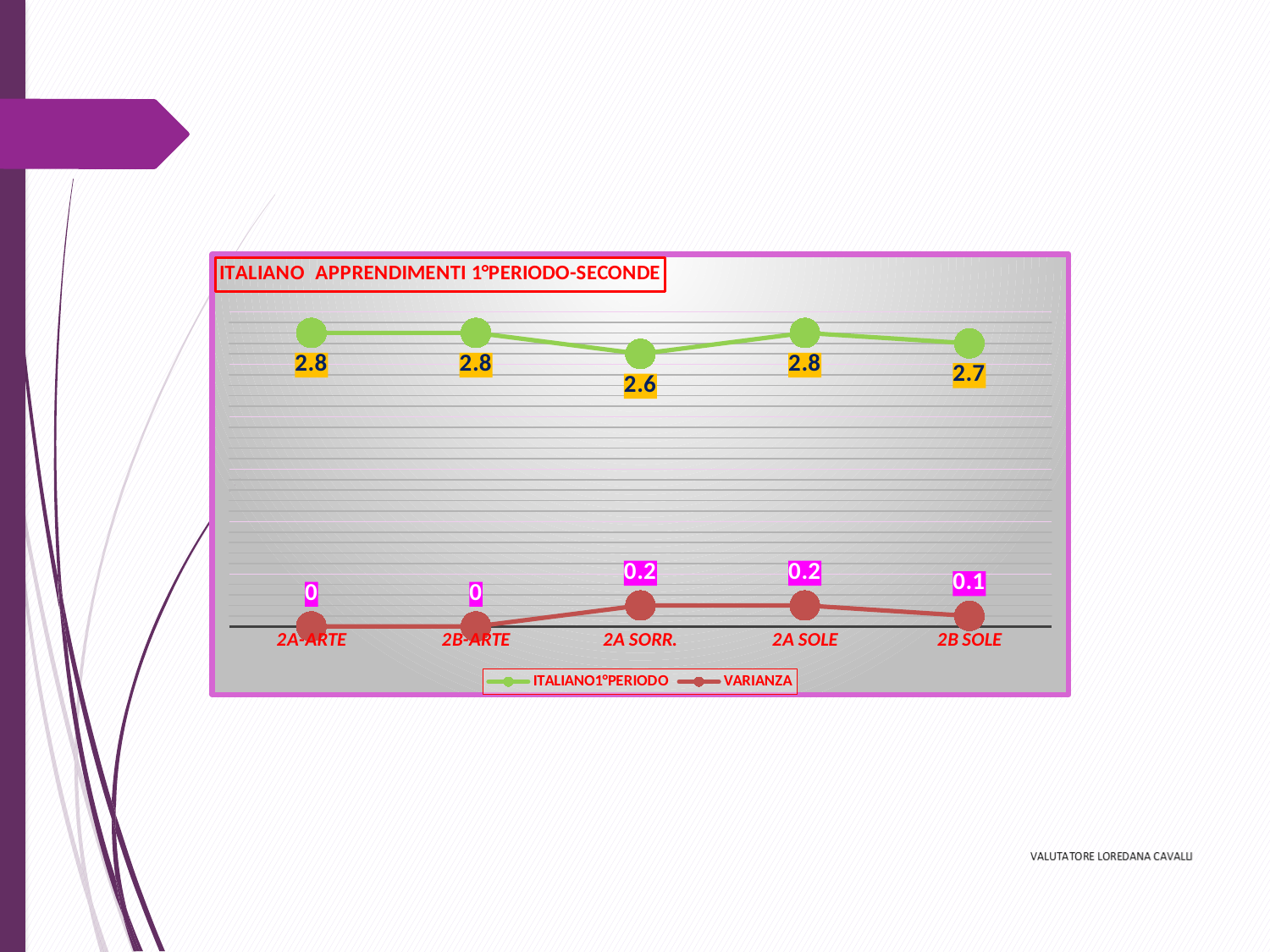
What is the VARIANZA value for 2B SOLE? 0.1 What kind of chart is shown on the slide? line chart Which is larger, the ITALIANO1°PERIODO value for 2A SOLE or for 2B SOLE? 2A SOLE How many categories are shown on the x axis? 5 Which category has the lowest ITALIANO1°PERIODO value? 2A SORR. What is the difference between the ITALIANO1°PERIODO values for 2A ARTE and 2A SORR.? 0.2 What is the title of the chart? ITALIANO APPRENDIMENTI 1°PERIODO-SECONDE What colour is the ITALIANO1°PERIODO line? green How many series does the legend list? 2 What is the ITALIANO1°PERIODO value for 2A SORR.? 2.6 What is the ITALIANO1°PERIODO value for 2B SOLE? 2.7 What is the VARIANZA value for 2A SOLE? 0.2